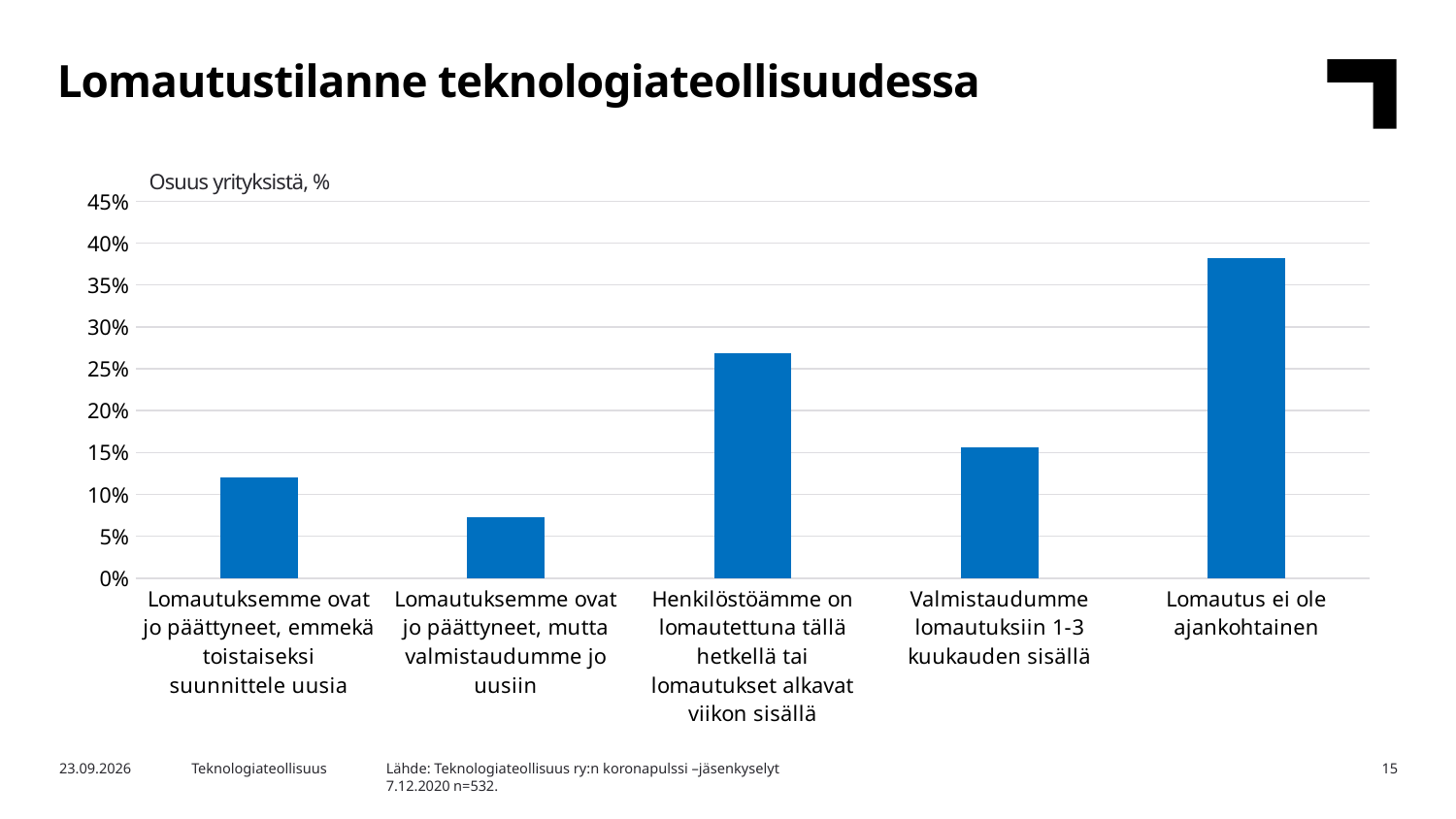
Which is larger: the value for 'Henkilöstöämme on lomautettuna tällä hetkellä tai lomautukset alkavat viikon sisällä' or the value for 'Valmistaudumme lomautuksiin 1-3 kuukauden sisällä'? Henkilöstöämme on lomautettuna tällä hetkellä tai lomautukset alkavat viikon sisällä Is the value for 'Lomautuksemme ovat jo päättyneet, emmekä toistaiseksi suunnittele uusia' greater or less than 10%? greater Is the value for 'Henkilöstöämme on lomautettuna tällä hetkellä tai lomautukset alkavat viikon sisällä' greater or less than 25%? greater Is the value for 'Lomautus ei ole ajankohtainen' greater or less than 40%? less Which category has the lowest value in the chart? Lomautuksemme ovat jo päättyneet, mutta valmistaudumme jo uusiin Which category has the highest value in the chart? Lomautus ei ole ajankohtainen How many categories are shown on the x axis of the chart? 5 What is the label shown above the y axis of the chart? Osuus yrityksistä, % What kind of chart is shown on the slide? bar chart